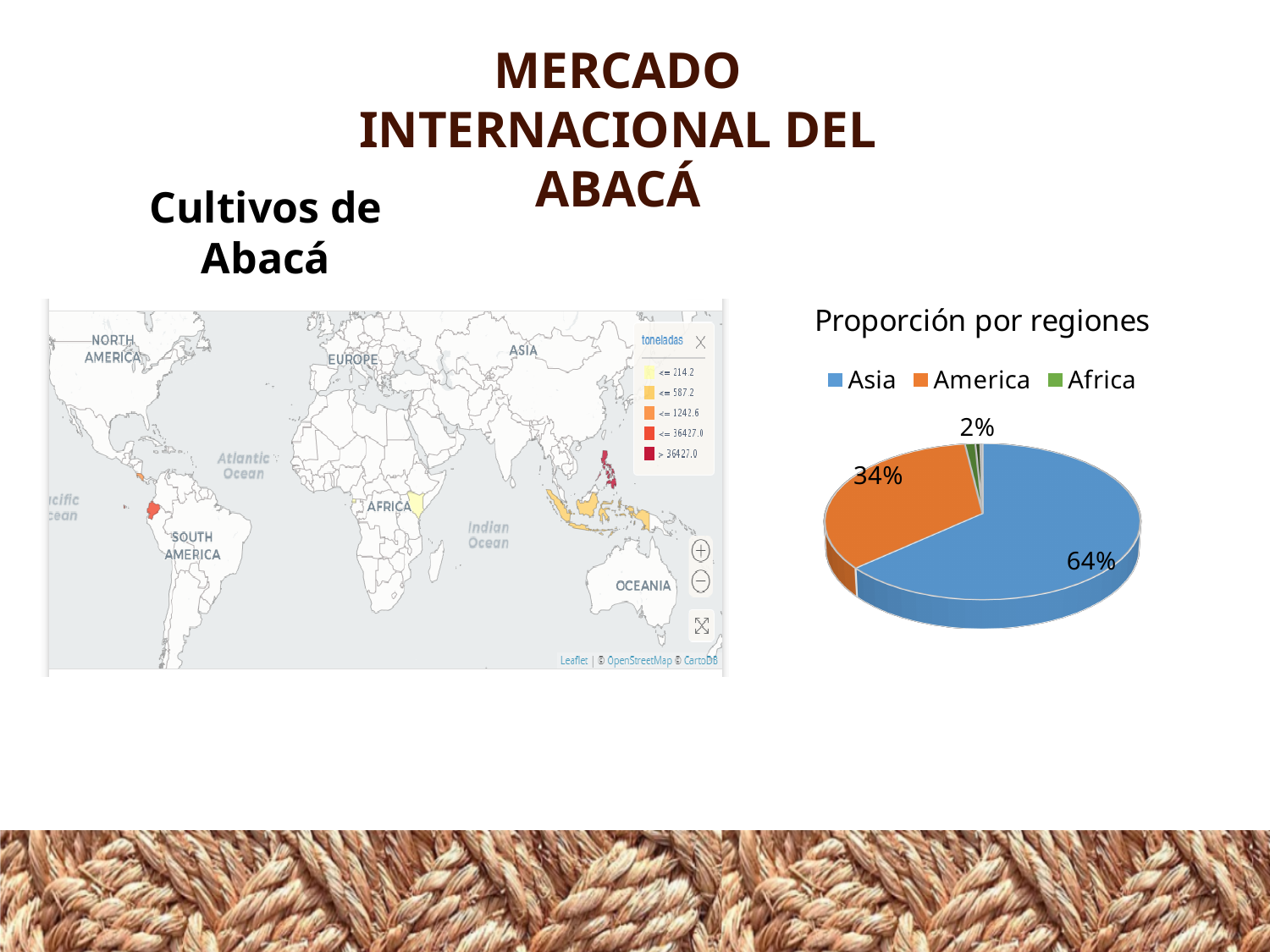
In the pie chart 'Proporción por regiones', what colour is the Asia slice? Blue What is the title of the pie chart on the right side of the slide? Proporción por regiones In the pie chart 'Proporción por regiones', which is larger, the share for America or the share for Africa? America In the pie chart 'Proporción por regiones', what share does Asia have? 64% In the pie chart 'Proporción por regiones', how many regions are shown? 3 In the pie chart 'Proporción por regiones', what share does America have? 34% In the pie chart 'Proporción por regiones', which region has the smallest share? Africa What kind of chart is 'Proporción por regiones'? Pie chart In the pie chart 'Proporción por regiones', what share does Africa have? 2% In the pie chart 'Proporción por regiones', what is the difference in percentage points between Asia and America? 30 How many entries does the legend of the pie chart 'Proporción por regiones' list? 3 In the pie chart 'Proporción por regiones', which region has the largest share? Asia